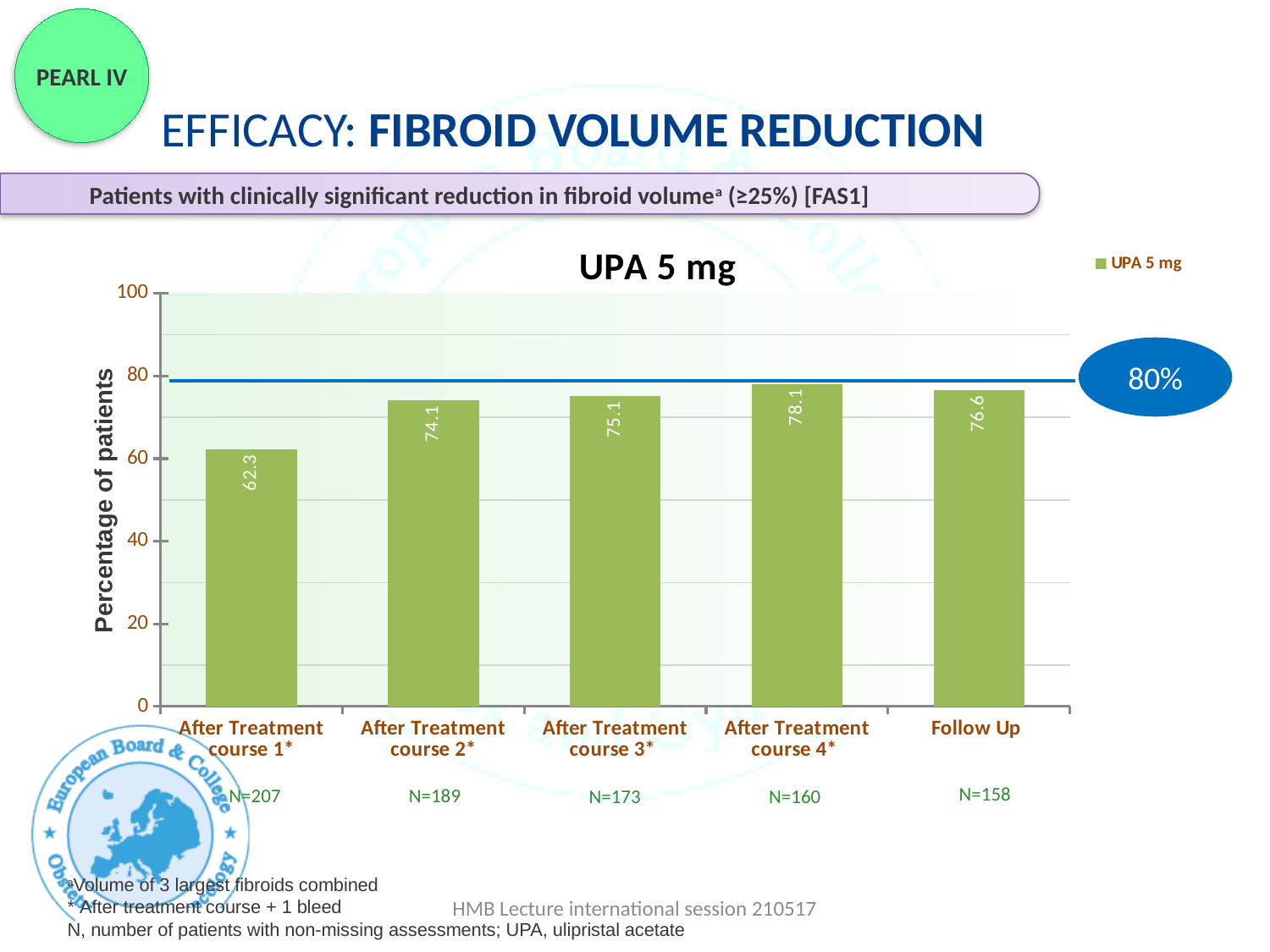
What is the title of the chart? UPA 5 mg Which category has the lowest value? After Treatment course 1* What is the value for After Treatment course 3*? 75.1 What is the difference between the values for After Treatment course 4* and After Treatment course 1*? 15.8 Is the value for After Treatment course 4* greater or less than 80? less What kind of chart is shown? bar chart How many categories are shown on the x axis? 5 How many series does the legend list? 1 Which is larger, the value for After Treatment course 2* or After Treatment course 1*? After Treatment course 2* What is the value for After Treatment course 1*? 62.3 Which category has the highest value? After Treatment course 4* What is the value for Follow Up? 76.6